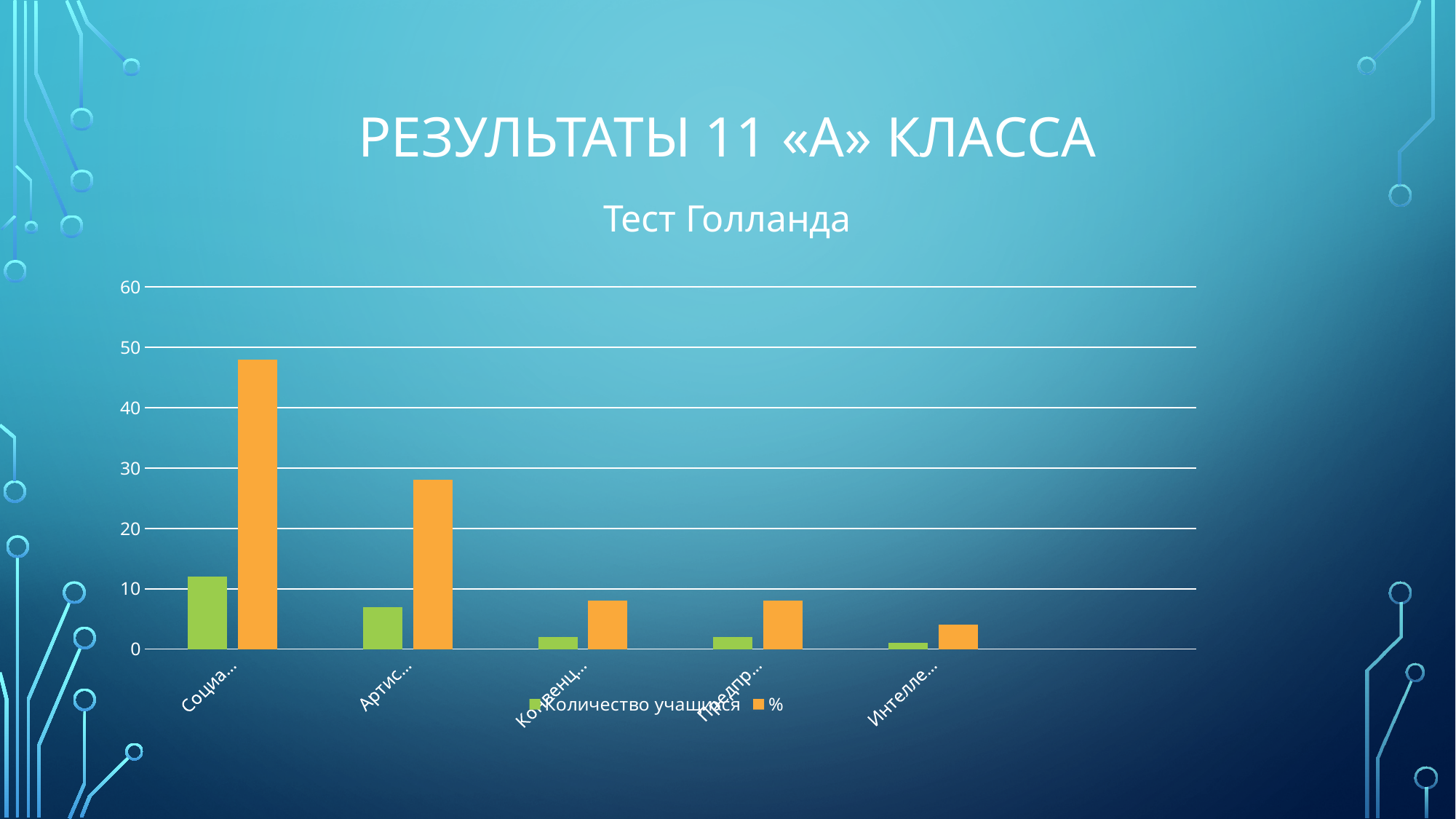
How many series does the legend list? 2 Is the "%" value for the second category (Артис...) greater or less than 20? greater What kind of chart is shown on the slide? bar chart Which colour represents the "%" series? orange Which category has the lowest value for the "%" series? Интелле... (the last category) Which is larger: the "%" value for Социа... or the "%" value for Артис...? Социа... What is the title of the chart? Тест Голланда Is the "Количество учащихся" value for the first category (Социа...) greater or less than 10? greater Is the "%" value for the last category (Интелле...) greater or less than 10? less Which category has the highest value for the "%" series? Социа... (the first category) How many categories are shown on the x axis? 5